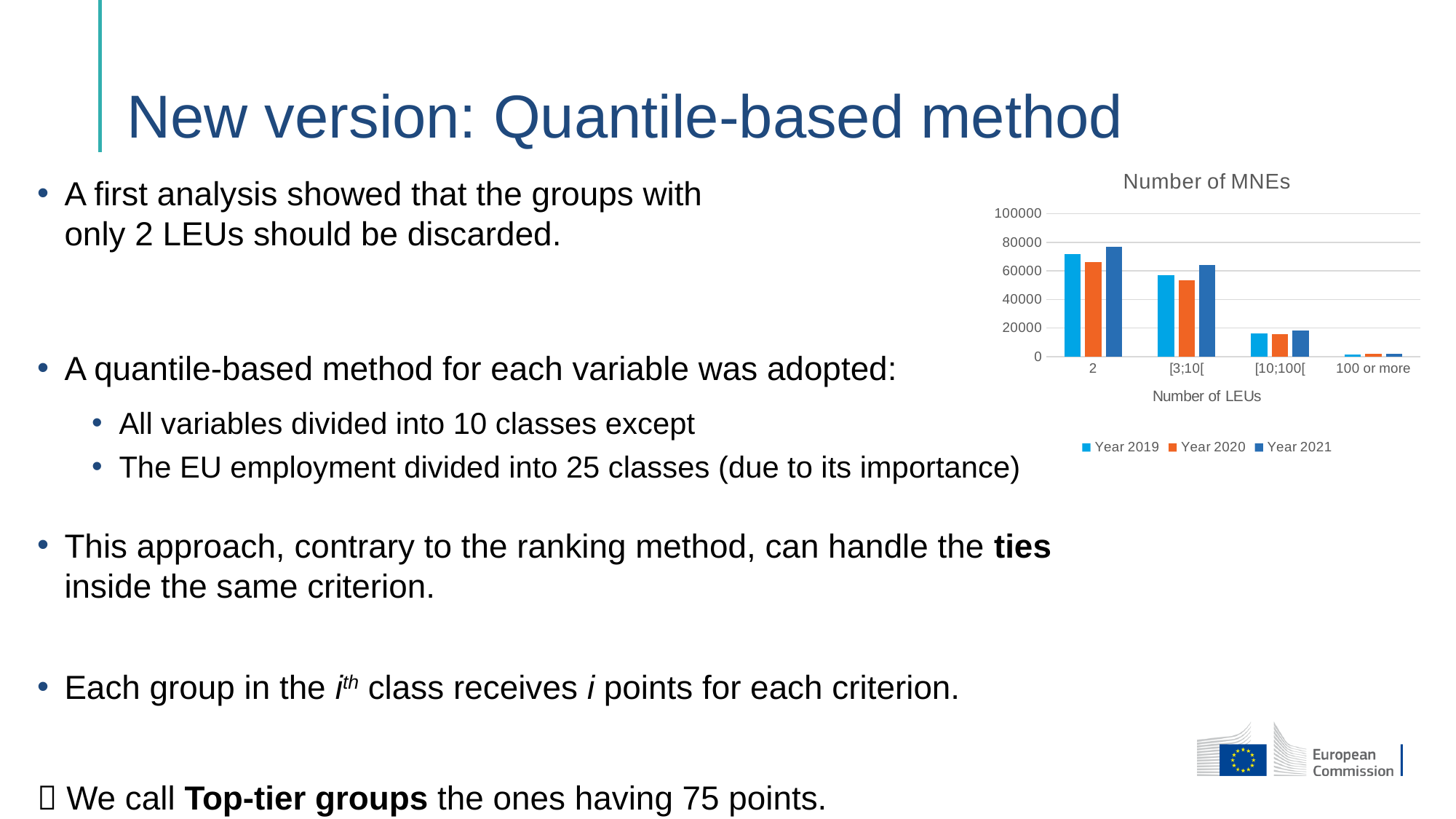
Is the Year 2020 value for the category [10;100[ greater or less than 20000? less For the category 2, which is larger: the Year 2020 value or the Year 2021 value? Year 2021 Which category has the lowest number of MNEs for Year 2019? 100 or more Which category has the highest number of MNEs for Year 2021? 2 How many series does the chart legend list? 3 What is the label of the x axis of the chart? Number of LEUs Is the Year 2019 value for the category [3;10[ greater or less than 40000? greater Is the Year 2021 value for the category 2 greater or less than 60000? greater What kind of chart is shown on the slide? bar chart Do the values for Year 2019 rise or fall moving from the category 2 to the category 100 or more? fall How many categories are shown on the x axis of the chart? 4 What is the title of the chart? Number of MNEs